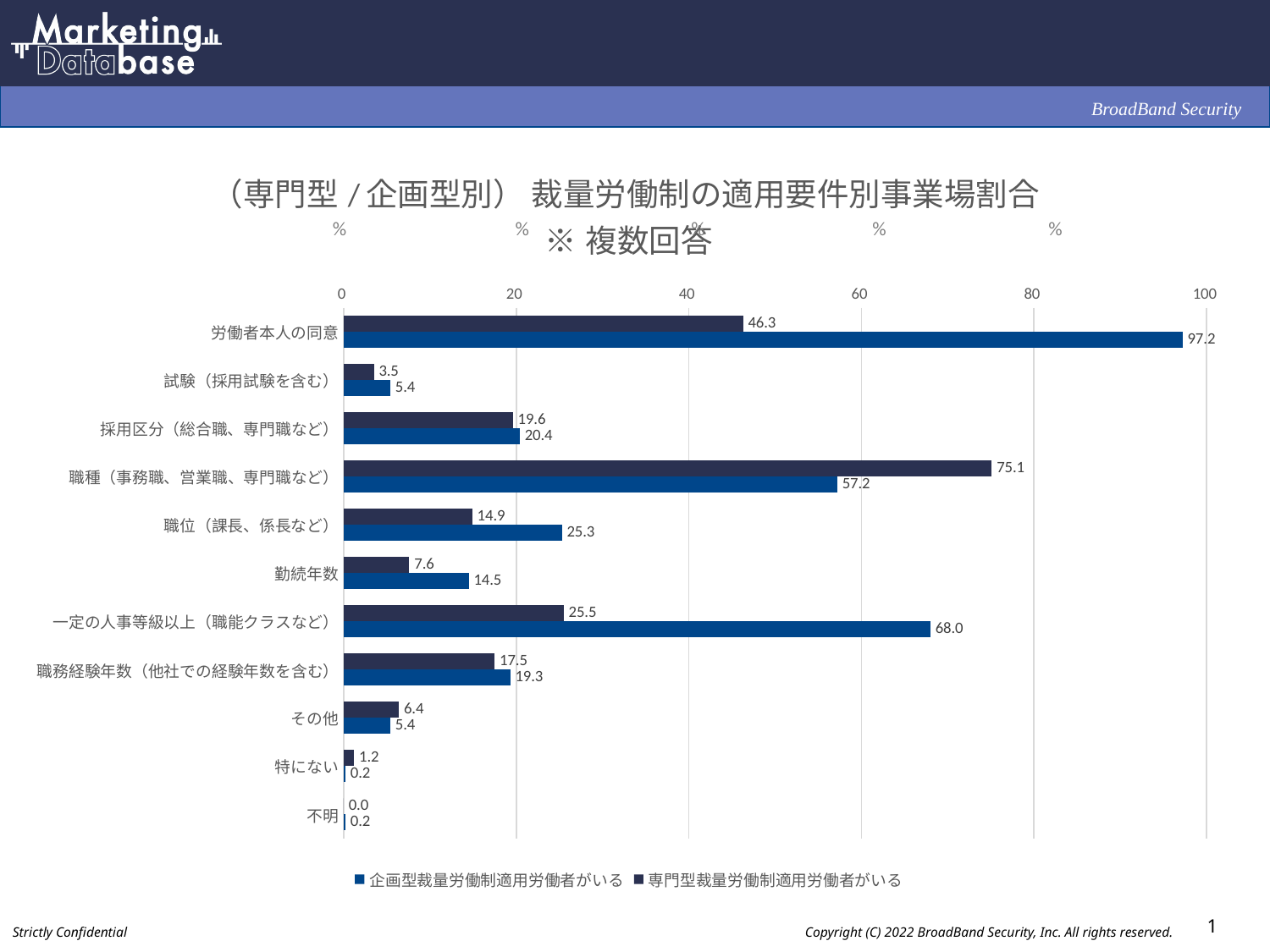
Which category has the highest value in the 専門型裁量労働制適用労働者がいる series? 職種（事務職、営業職、専門職など） What is the value for 一定の人事等級以上（職能クラスなど） in the 企画型裁量労働制適用労働者がいる series? 68.0 Which category has the lowest value in the 専門型裁量労働制適用労働者がいる series? 不明 How many series does the legend list? 2 What is the difference between the 専門型 and 企画型 values for 職種（事務職、営業職、専門職など）? 17.9 What is the value for 勤続年数 in the 専門型裁量労働制適用労働者がいる series? 7.6 For 職位（課長、係長など）, which series has the larger value? 企画型裁量労働制適用労働者がいる What is the value for 職種（事務職、営業職、専門職など） in the 専門型裁量労働制適用労働者がいる series? 75.1 How many categories are plotted on the chart? 11 What is the difference between the 企画型 and 専門型 values for 労働者本人の同意? 50.9 What kind of chart is shown on the slide? bar chart What is the value for 労働者本人の同意 in the 企画型裁量労働制適用労働者がいる series? 97.2